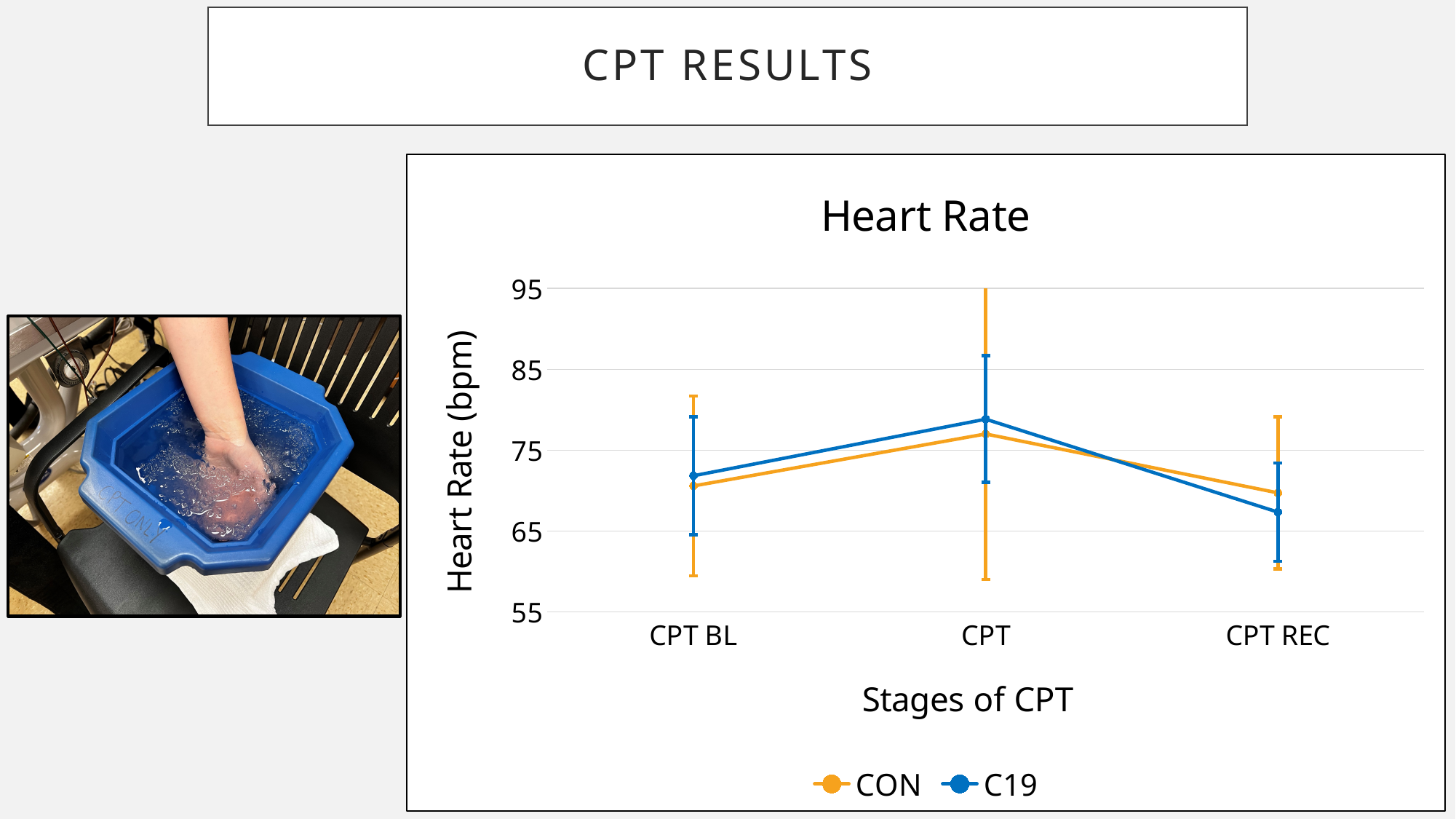
How many stages are shown on the x axis of the Heart Rate chart? 3 Is the C19 heart rate at CPT greater or less than 75? greater At CPT REC, which series has the higher heart rate, CON or C19? CON At which stage is the C19 heart rate lowest? CPT REC What is the label of the y axis on the Heart Rate chart? Heart Rate (bpm) How many series does the legend of the Heart Rate chart list? 2 What kind of chart is shown on the slide? line chart Is the C19 heart rate at CPT REC greater or less than 75? less Is the CON heart rate at CPT BL greater or less than 75? less Does the C19 heart rate rise or fall from CPT to CPT REC? fall At which stage does the C19 series reach its highest heart rate? CPT At which stage does the CON series reach its highest heart rate? CPT